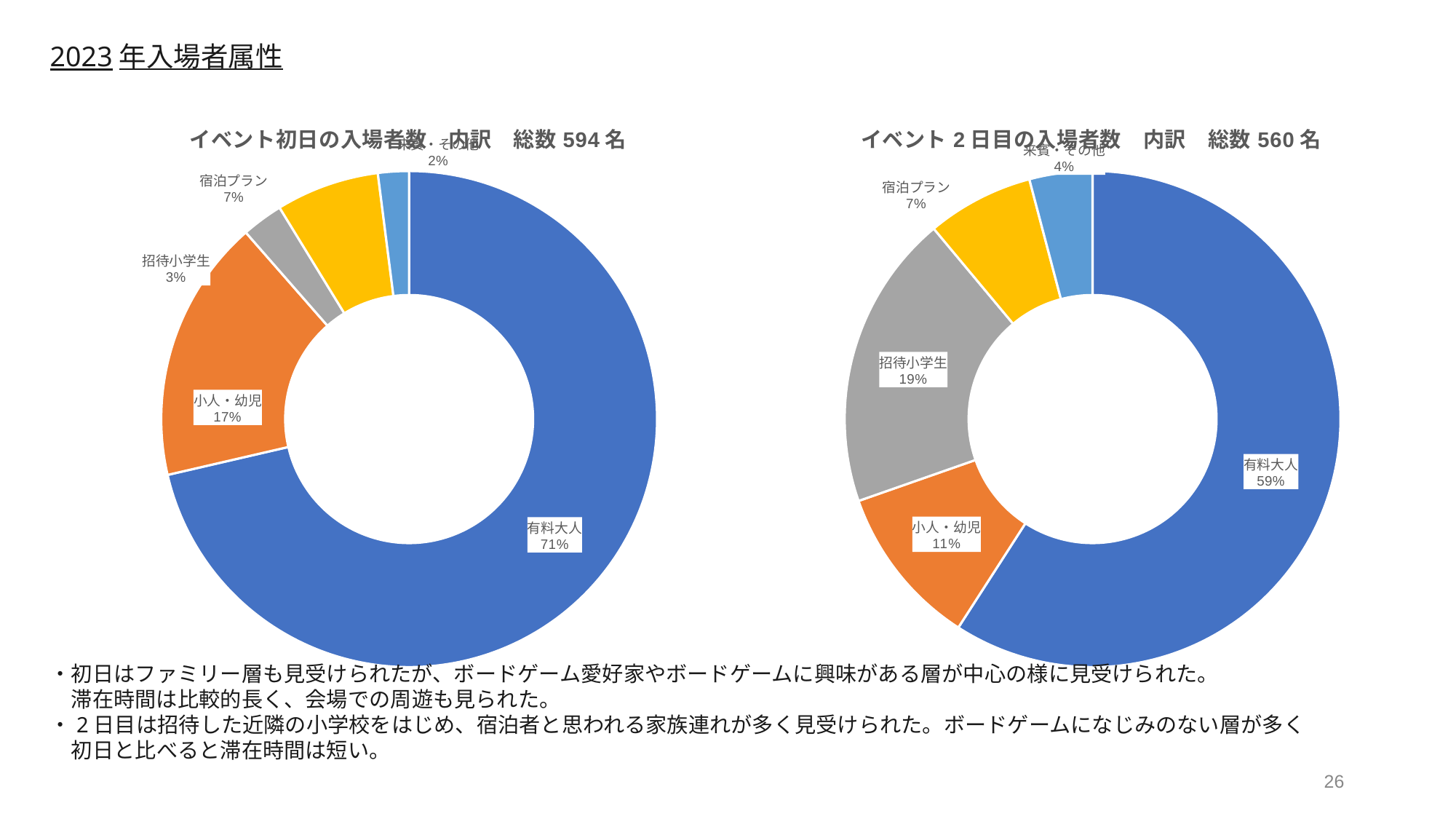
In the right chart (イベント2日目の入場者数 内訳), what share is 招待小学生? 19% In the left chart (イベント初日の入場者数 内訳), what share is 小人・幼児? 17% In the left chart (イベント初日の入場者数 内訳), what share is 有料大人? 71% In the right chart (イベント2日目の入場者数 内訳), which is larger: 招待小学生 or 小人・幼児? 招待小学生 In the left chart (イベント初日の入場者数 内訳), which category has the largest share? 有料大人 How many percentage points higher is the 有料大人 share in the left chart (初日) than in the right chart (2日目)? 12 percentage points In the right chart (イベント2日目の入場者数 内訳), what share is 宿泊プラン? 7% In the right chart (イベント2日目の入場者数 内訳), what share is 有料大人? 59% How many slices does the left chart (イベント初日の入場者数 内訳) have? 5 In the left chart (イベント初日の入場者数 内訳), what share is 招待小学生? 3% According to the chart titles, what is the total number of visitors on the first day and on the second day? 594名 and 560名 What kind of chart is the left chart (イベント初日の入場者数 内訳)? Pie chart (donut)